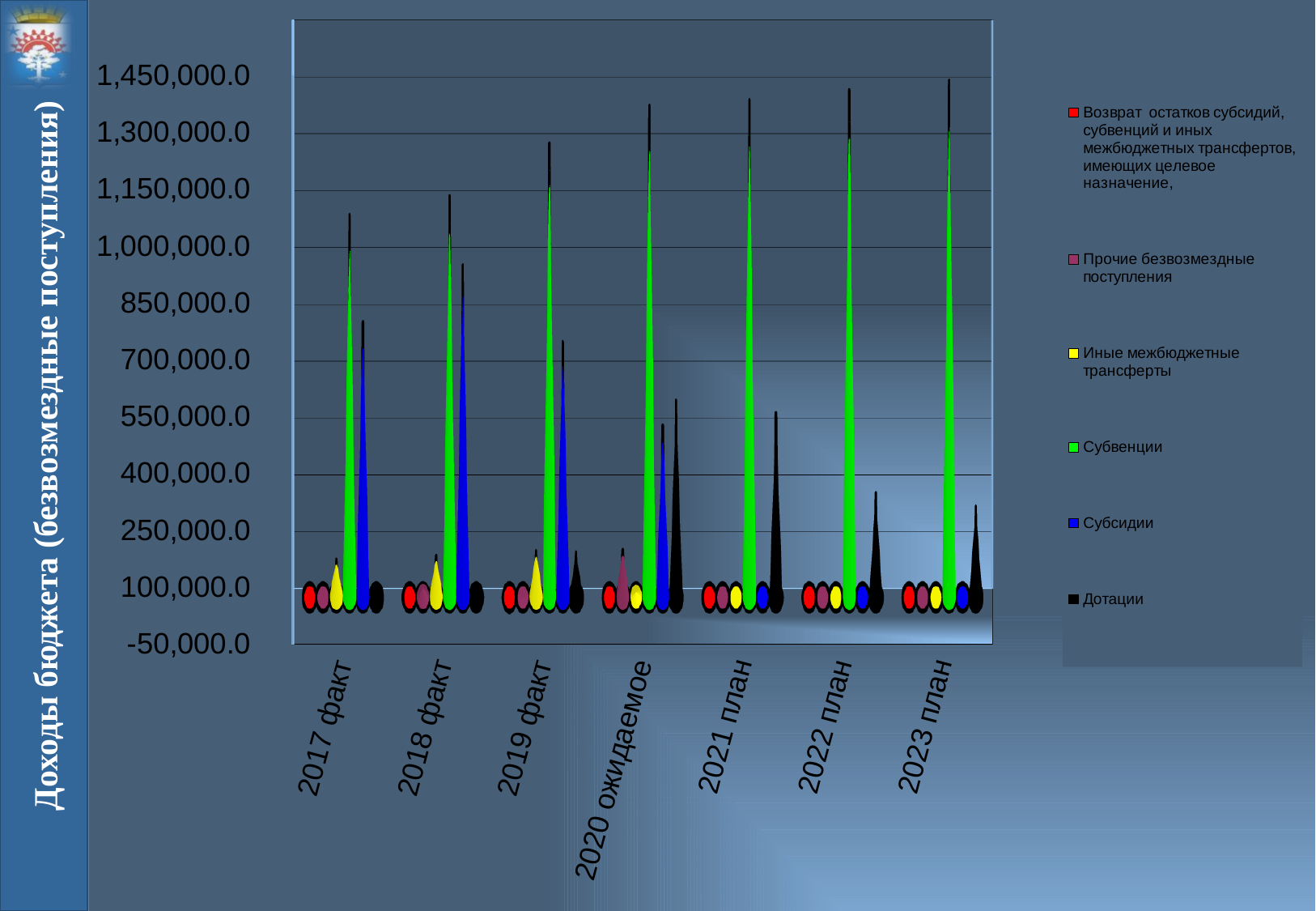
Is the value of Субвенции for 2023 план greater or less than 1,150,000.0? greater Which series has the highest value in the 2019 факт category? Субвенции Is the value of Субсидии for 2021 план greater or less than 100,000.0? less What kind of chart is shown on the slide? bar chart Is the value of Субвенции for 2017 факт greater or less than 850,000.0? greater Which series has the highest value in the 2017 факт category? Субвенции In the 2018 факт category, which is larger: Субвенции or Субсидии? Субвенции How many categories are shown on the x axis of the chart? 7 Which colour represents the Субвенции series in the legend? green How many series does the chart's legend list? 6